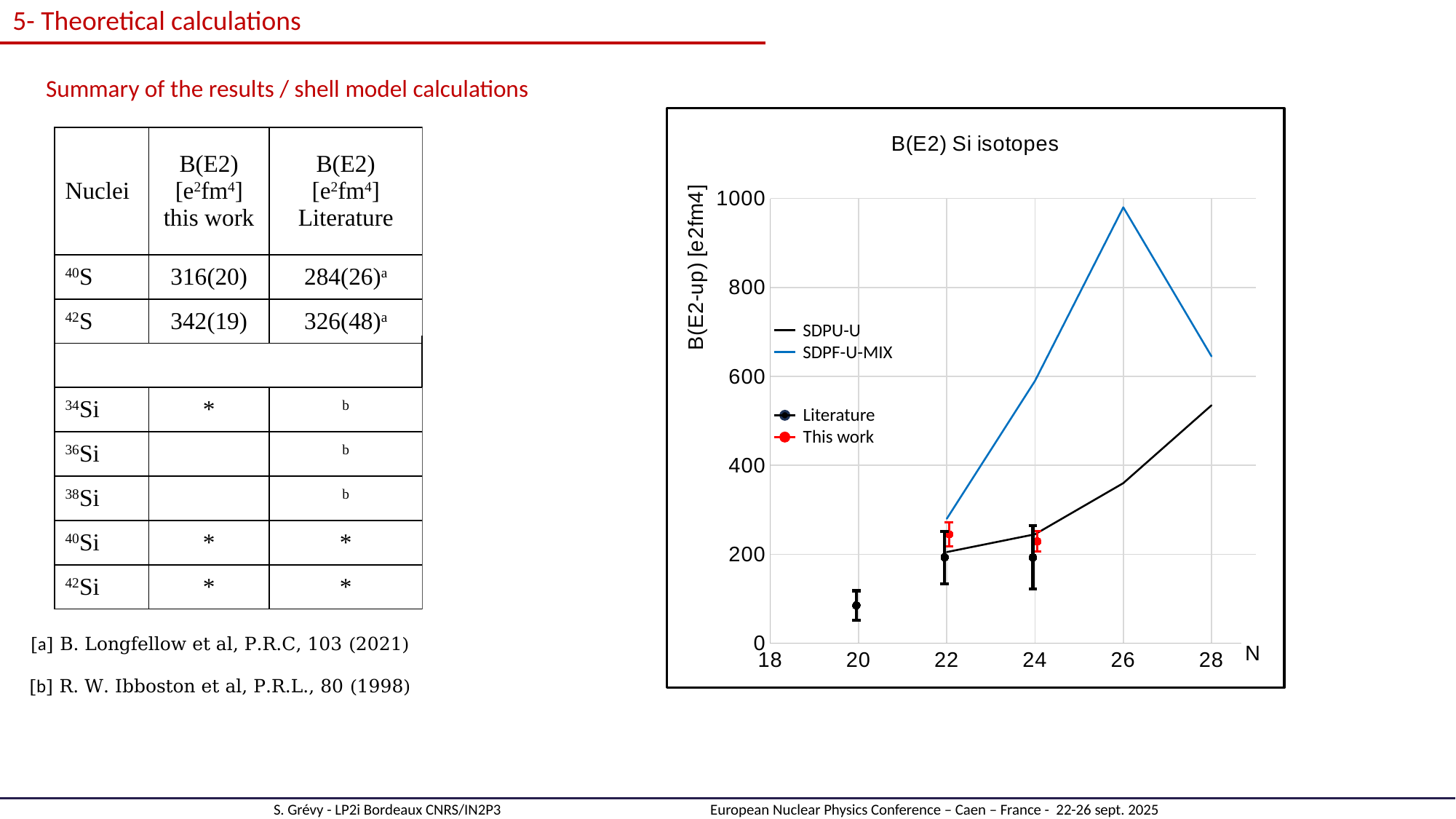
At which value of N does the SDPF-U-MIX curve reach its highest value? 26 Is the Literature value at N = 20 greater or less than 200? less At N = 26, which is larger: the SDPF-U-MIX value or the SDPU-U value? SDPF-U-MIX Does the SDPU-U curve rise or fall as N increases from 22 to 28? rise Is the SDPF-U-MIX value at N = 26 greater or less than 800? greater Is the SDPU-U value at N = 28 greater or less than 400? greater What is the title of the chart? B(E2) Si isotopes What kind of chart is shown on the slide? line chart How many 'This work' data points are plotted on the chart? 2 How many Literature data points are plotted on the chart? 3 How many series does the chart legend list? 4